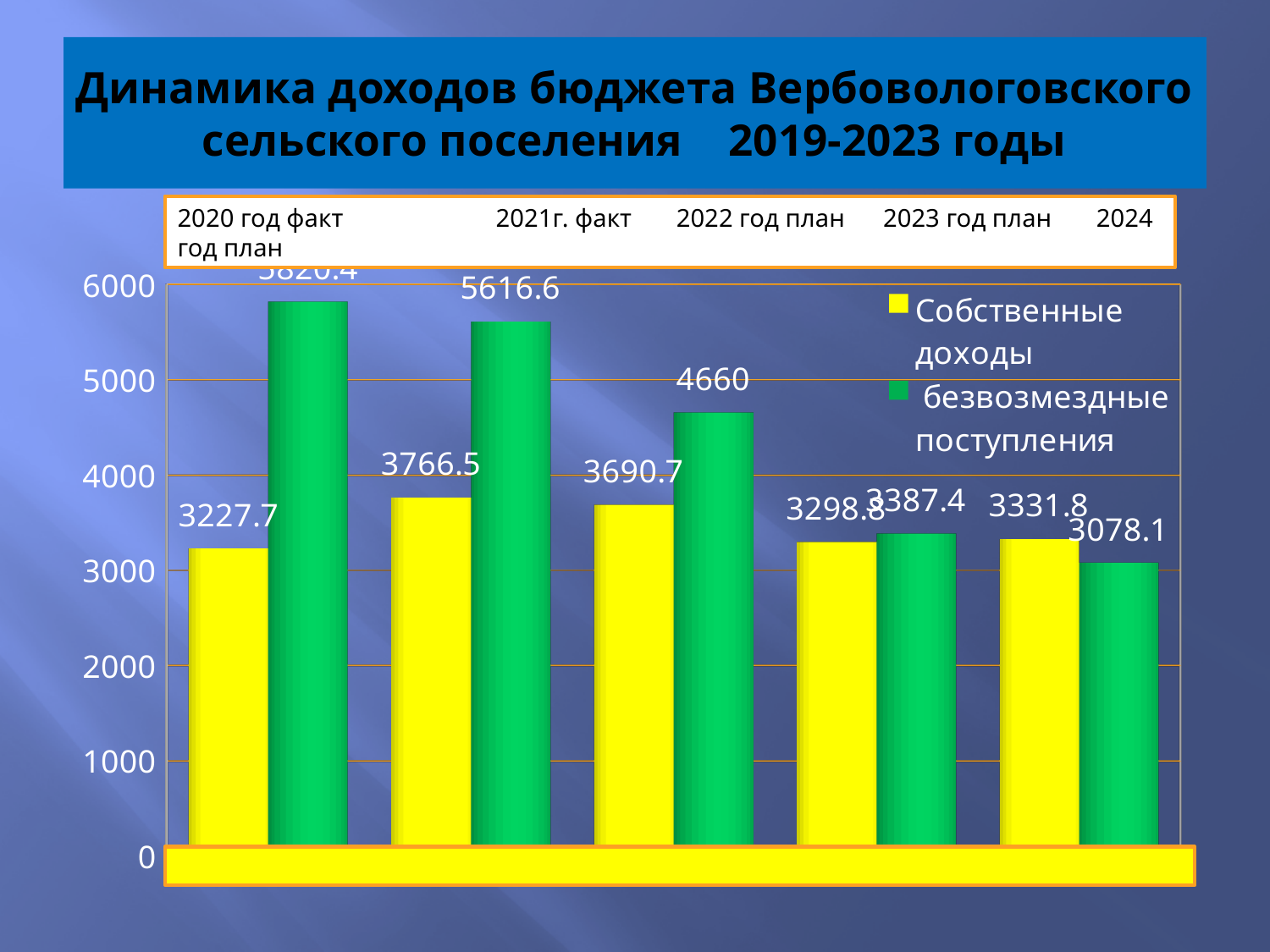
How many series does the legend list? 2 What is the difference between безвозмездные поступления and Собственные доходы for 2021г. факт? 1850.1 What is the value of безвозмездные поступления for 2023 год план? 3387.4 What is the value of безвозмездные поступления for 2022 год план? 4660 Which year has the lowest value of безвозмездные поступления? 2024 год план How many year categories are shown on the x axis? 5 Which colour represents безвозмездные поступления in the chart? green What is the value of Собственные доходы for 2024 год план? 3331.8 Which year has the lowest value of Собственные доходы? 2020 год факт What is the value of Собственные доходы for 2021г. факт? 3766.5 Is the value of безвозмездные поступления for 2020 год факт greater or less than 5000? greater What kind of chart is shown on the slide? bar chart